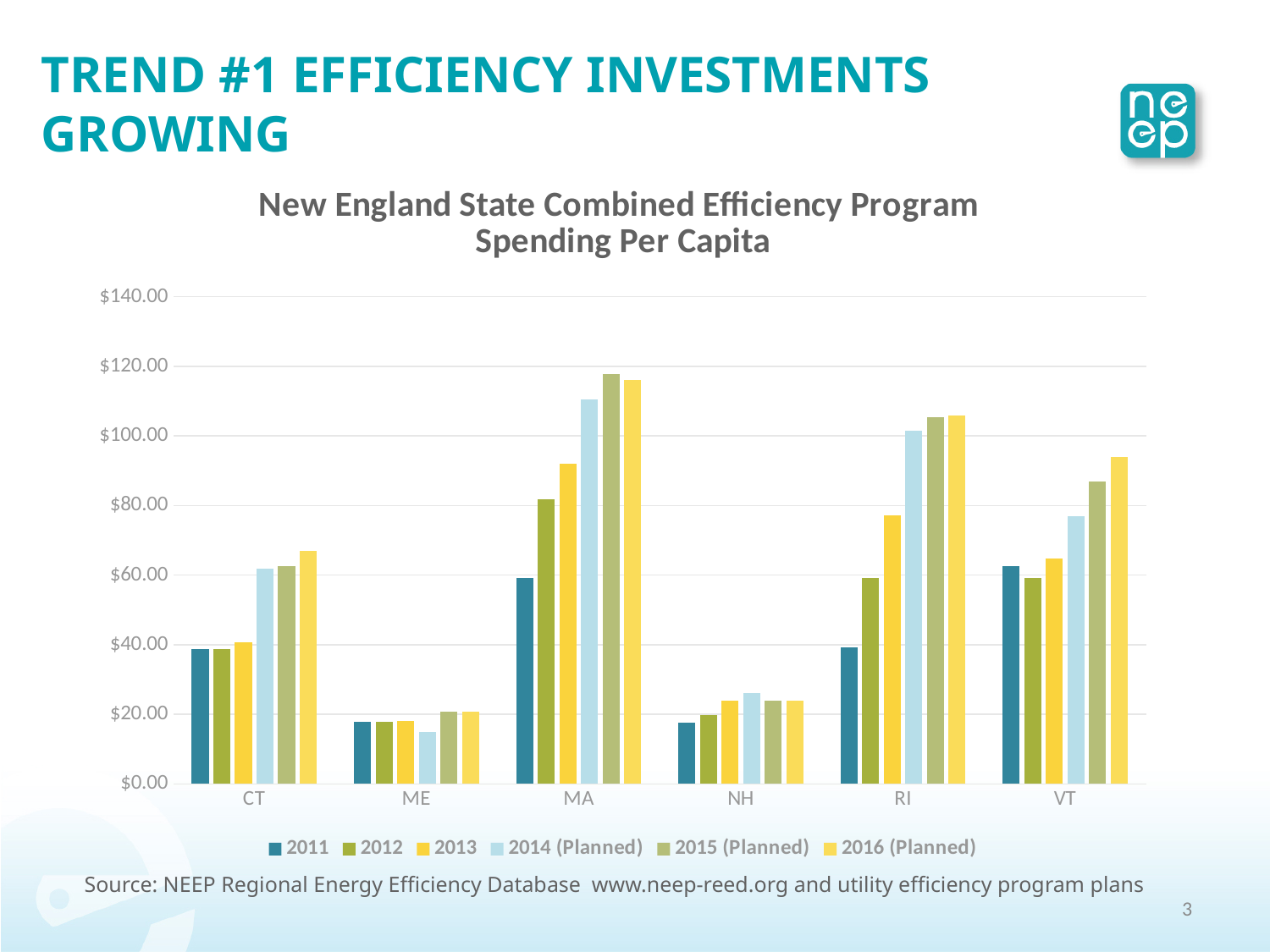
How many states are shown on the x axis? 6 What kind of chart is shown on the slide? bar chart Which state has the lowest 2016 (Planned) spending per capita? ME Is the 2016 (Planned) value for VT greater or less than $80.00? greater Which state has the highest 2015 (Planned) spending per capita? MA What is the title of the chart? New England State Combined Efficiency Program Spending Per Capita Is the 2015 (Planned) value for MA greater or less than $100.00? greater Which years in the legend are marked as Planned? 2014, 2015 and 2016 Which is larger, the 2011 value for RI or the 2011 value for VT? VT How many series does the legend list? 6 Is the 2014 (Planned) value for ME greater or less than $20.00? less Do the values for MA rise or fall from 2011 to 2015 (Planned)? rise